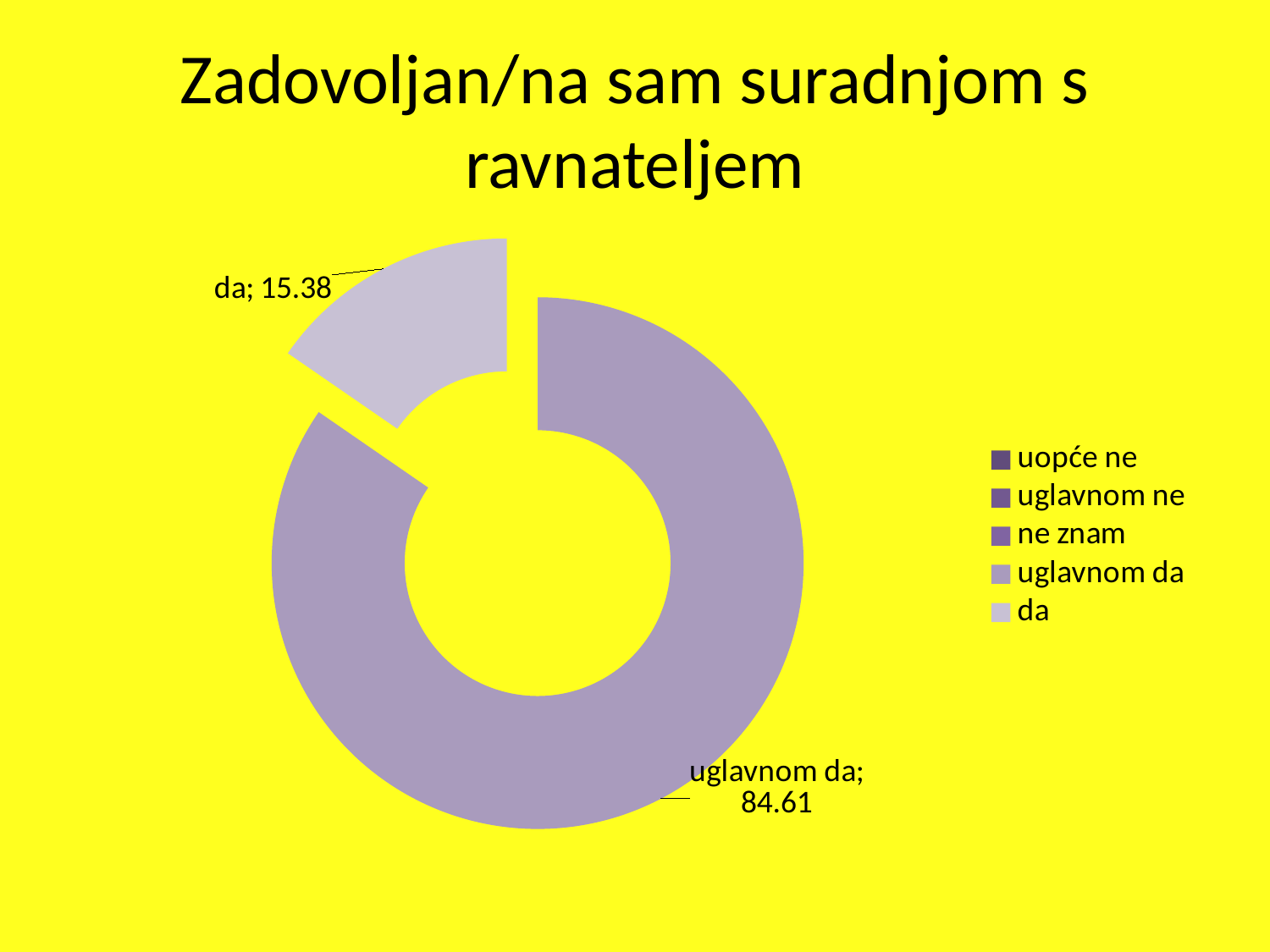
Which of the two labelled slices is smaller, "da" or "uglavnom da"? da Which legend entry is listed first? uopće ne How many slices have data labels shown on the chart? 2 What is the value shown for "da"? 15.38 What is the difference between the values for "uglavnom da" and "da"? 69.23 Which is larger, the value for "da" or the value for "uglavnom da"? uglavnom da How many entries does the legend list? 5 Which category has the largest slice? uglavnom da What is the title of the chart? Zadovoljan/na sam suradnjom s ravnateljem What kind of chart is shown on the slide? Doughnut chart What is the value shown for "uglavnom da"? 84.61